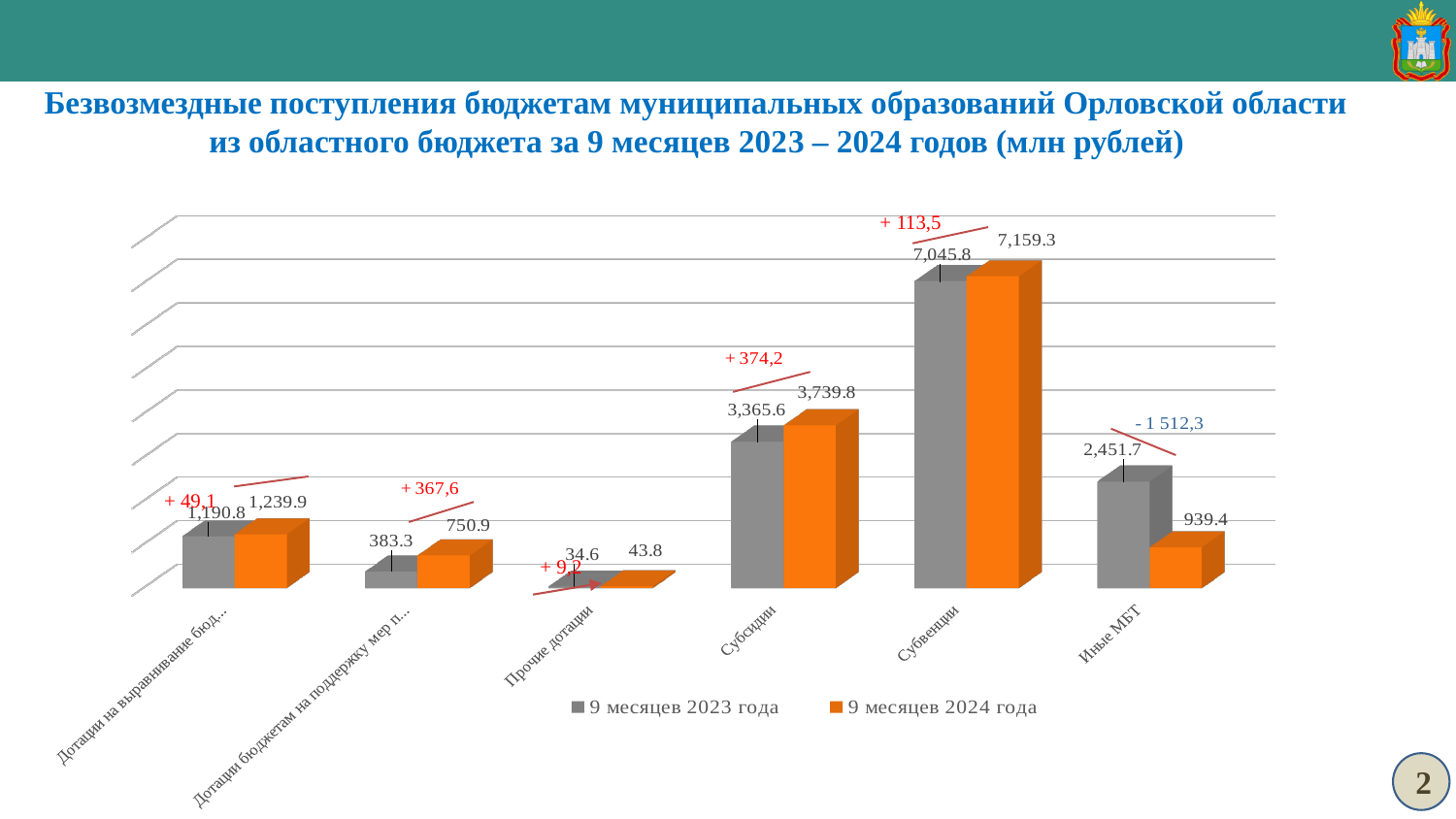
Which category has the highest value for 9 месяцев 2024 года? Субвенции What is the value for Прочие дотации for 9 месяцев 2023 года? 34.6 What is the difference between the 9 месяцев 2024 года and 9 месяцев 2023 года values for Субсидии? 374.2 For Иные МБТ, which is larger: the value for 9 месяцев 2023 года or for 9 месяцев 2024 года? 9 месяцев 2023 года What colour are the bars for 9 месяцев 2024 года? orange What is the value for Субсидии for 9 месяцев 2023 года? 3,365.6 What is the value for Иные МБТ for 9 месяцев 2024 года? 939.4 How many categories are shown on the x axis? 6 Which category has the lowest value for 9 месяцев 2023 года? Прочие дотации What kind of chart is shown on the slide? bar chart How many series does the legend list? 2 What is the value for Субвенции for 9 месяцев 2024 года? 7,159.3